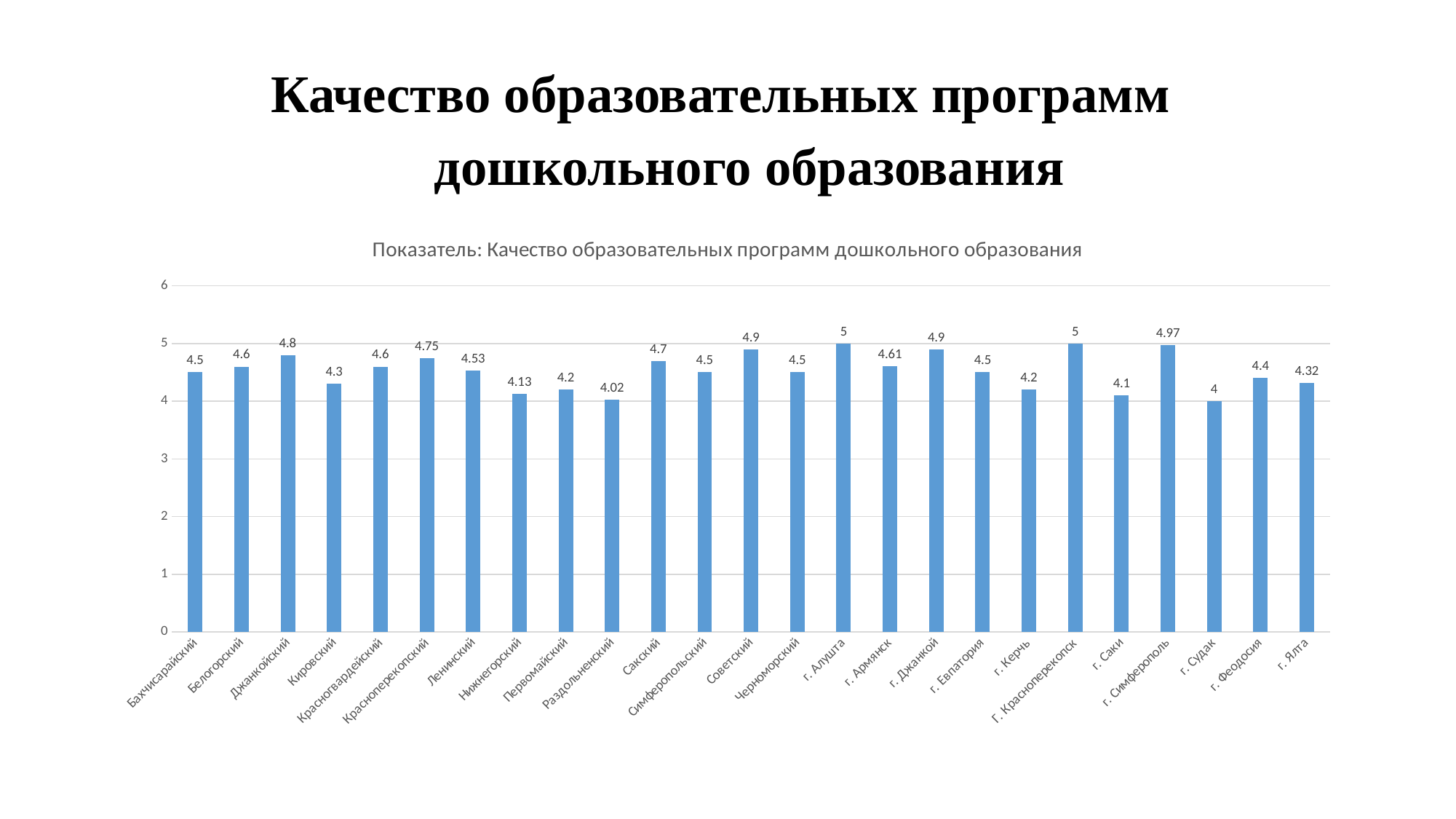
What is the value for г. Ялта? 4.32 What is the value for г. Симферополь? 4.97 Which is larger, the value for Сакский or the value for г. Керчь? Сакский What is the value for Красноперекопский? 4.75 How many categories are shown on the x axis? 25 Which category has the lowest value? г. Судак What is the title of the chart? Показатель: Качество образовательных программ дошкольного образования What is the difference between the values for Джанкойский and Кировский? 0.5 What is the difference between the values for г. Алушта and г. Саки? 0.9 Which is larger, the value for Советский or the value for Нижнегорский? Советский What is the value for Раздольненский? 4.02 What kind of chart is shown on the slide? Bar chart